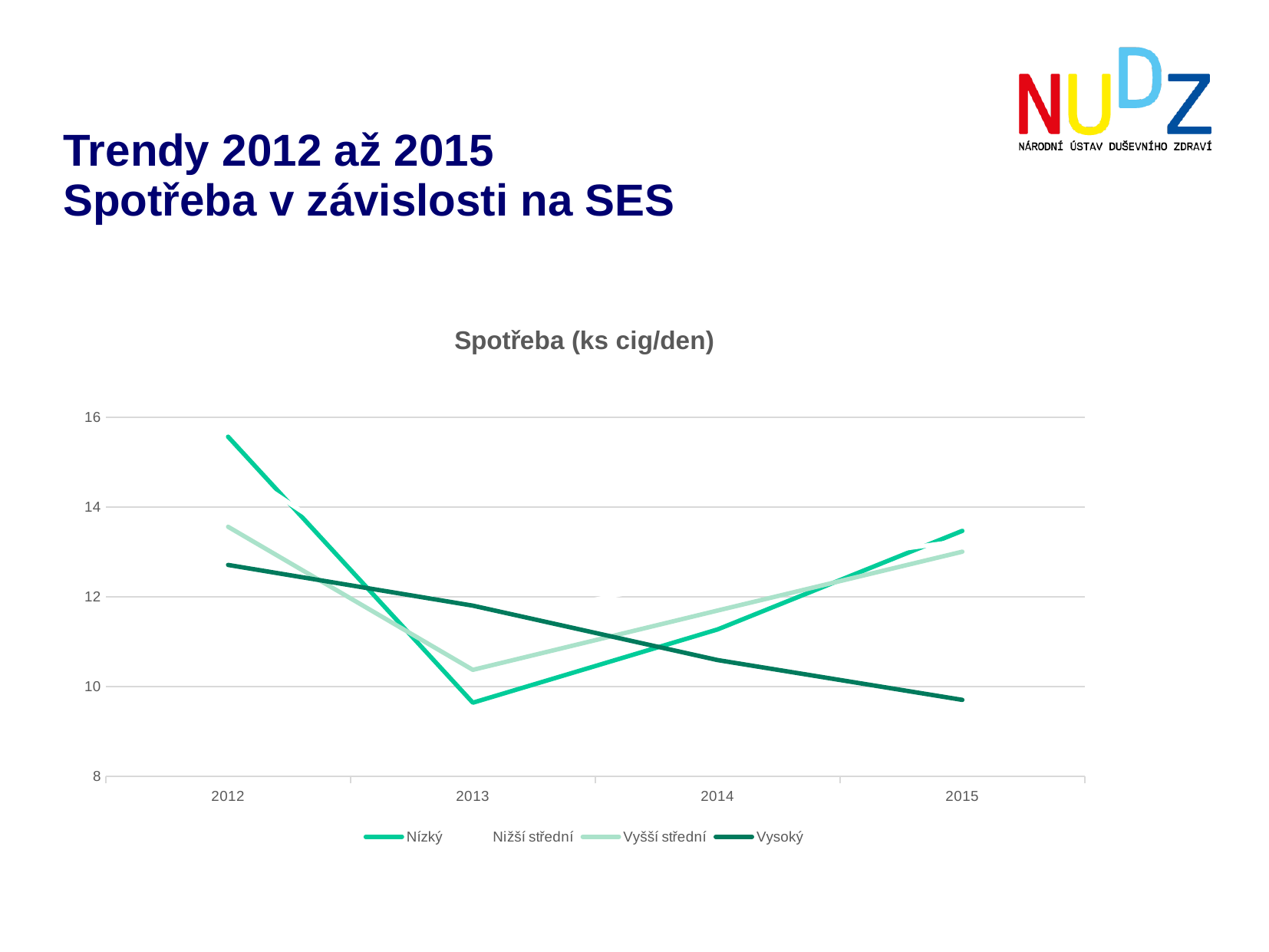
In 2013, which is larger: the value for Nízký or the value for Vysoký? Vysoký Is the value for Vysoký in 2015 greater or less than 10? less Does the Vysoký series rise or fall from 2012 to 2015? fall Is the value for Nízký in 2013 greater or less than 10? less Which series has the highest value in 2012? Nízký Is the value for Vysoký in 2012 greater or less than 12? greater What kind of chart is shown on the slide? line chart What is the title of the chart? Spotřeba (ks cig/den) How many series does the legend list? 4 How many years are shown on the x axis? 4 Which series has the lowest value in 2015? Vysoký